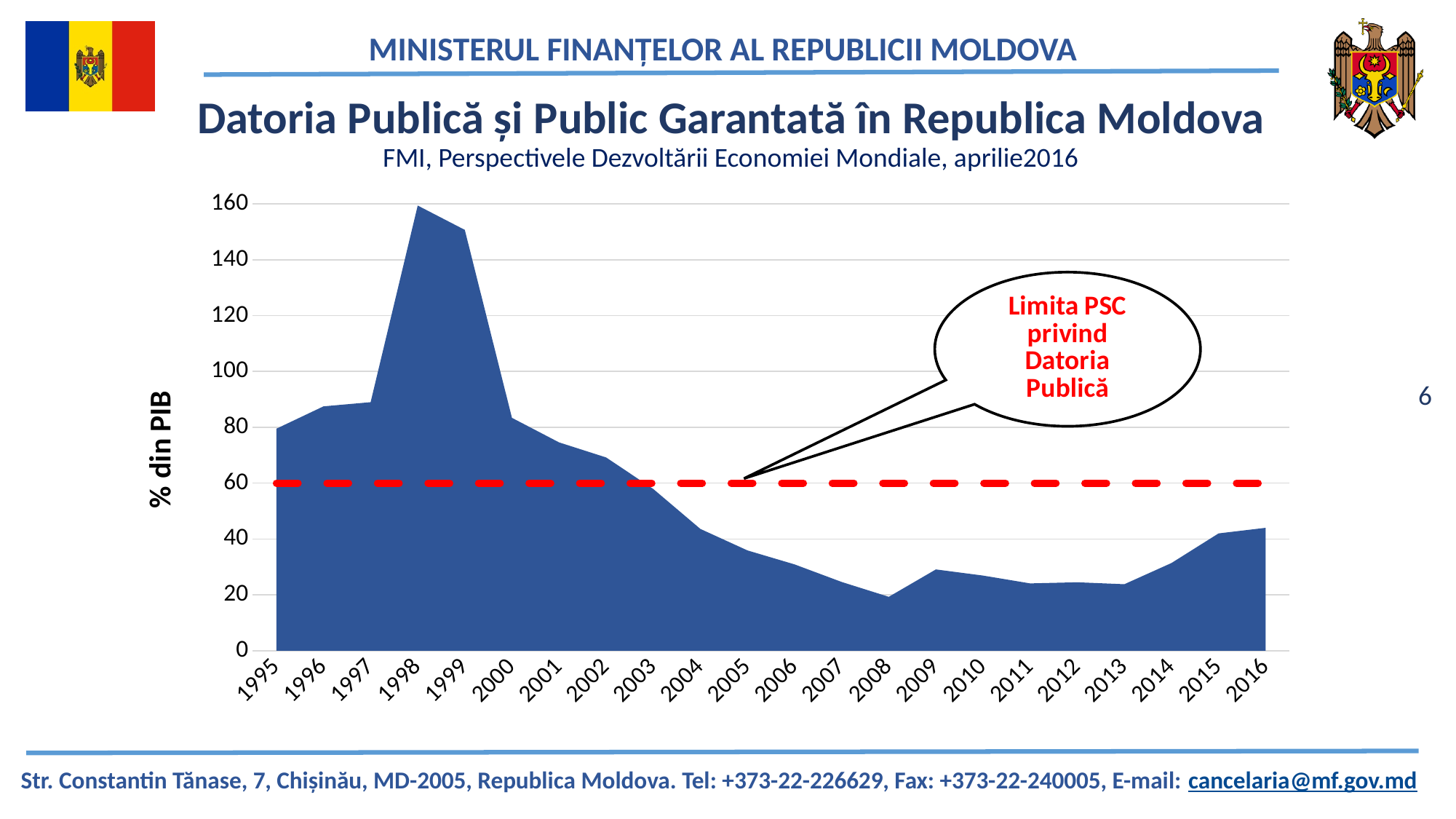
Is the value for 1995 greater or less than 60? greater In which year does the chart reach its lowest value? 2008 Do the values rise or fall from 1999 to 2008? fall Is the value for 2004 greater or less than 60? less What kind of chart is shown on the slide? area chart In which year does the chart reach its highest value? 1998 Is the value for 2013 greater or less than 40? less At what level on the y axis is the red dashed line labelled 'Limita PSC privind Datoria Publică' drawn? 60 How many years are shown on the x axis of the chart? 22 Which year has the larger value, 2008 or 2009? 2009 Which year has the larger value, 1998 or 2016? 1998